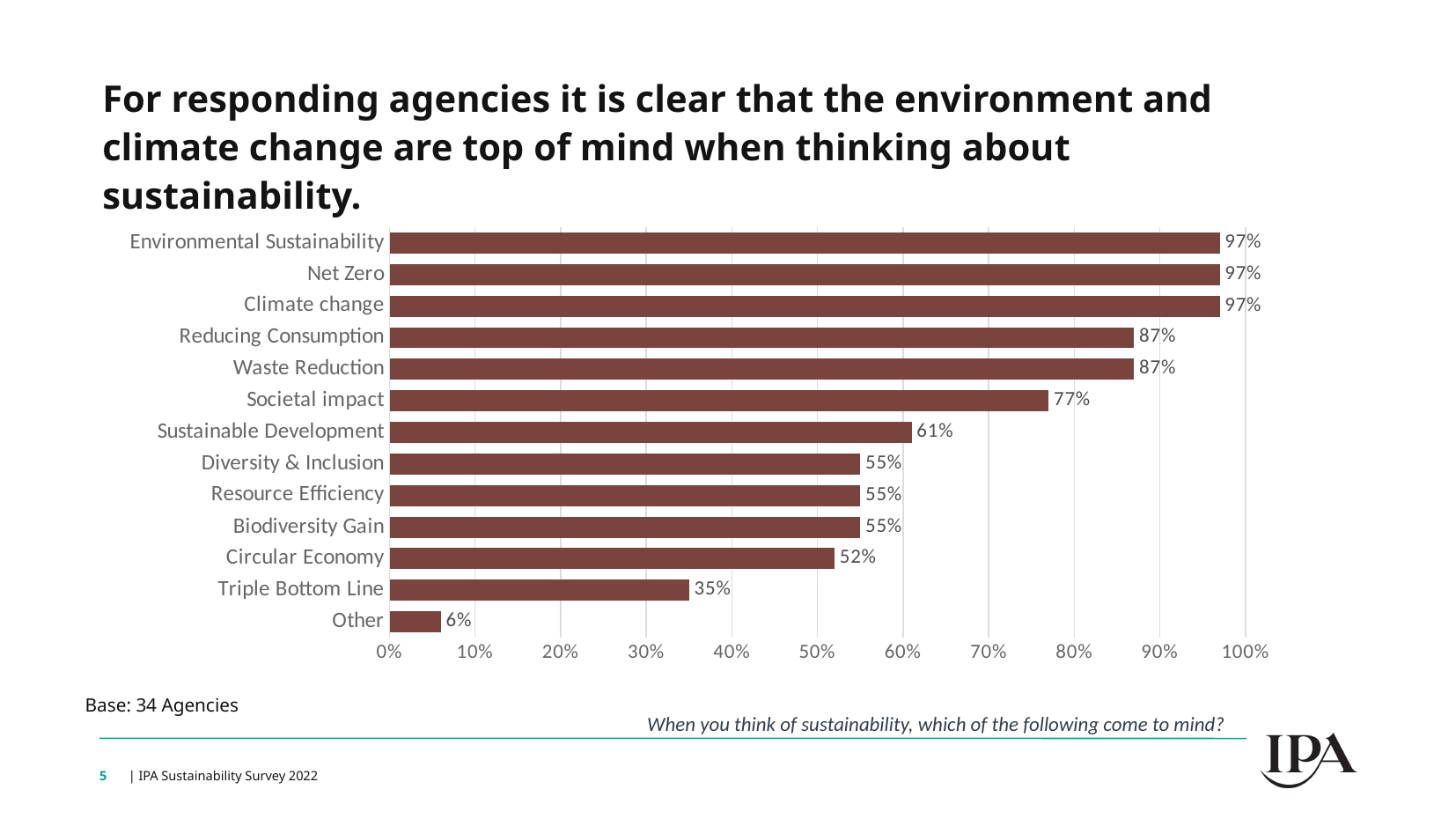
Which is larger, the value for Sustainable Development or the value for Circular Economy? Sustainable Development What is the value shown for Triple Bottom Line? 35% Which category has the lowest value on the chart? Other Is the value for Waste Reduction greater or less than 80%? greater What is the base (number of agencies) stated for the chart? 34 Agencies What is the value shown for Sustainable Development? 61% What is the value shown for Circular Economy? 52% What kind of chart is shown on the slide? Bar chart What percentage of agencies said Societal impact comes to mind when thinking of sustainability? 77% What is the difference between the values for Net Zero and Other? 91% What is the difference between the values for Reducing Consumption and Societal impact? 10% How many categories are shown on the chart? 13